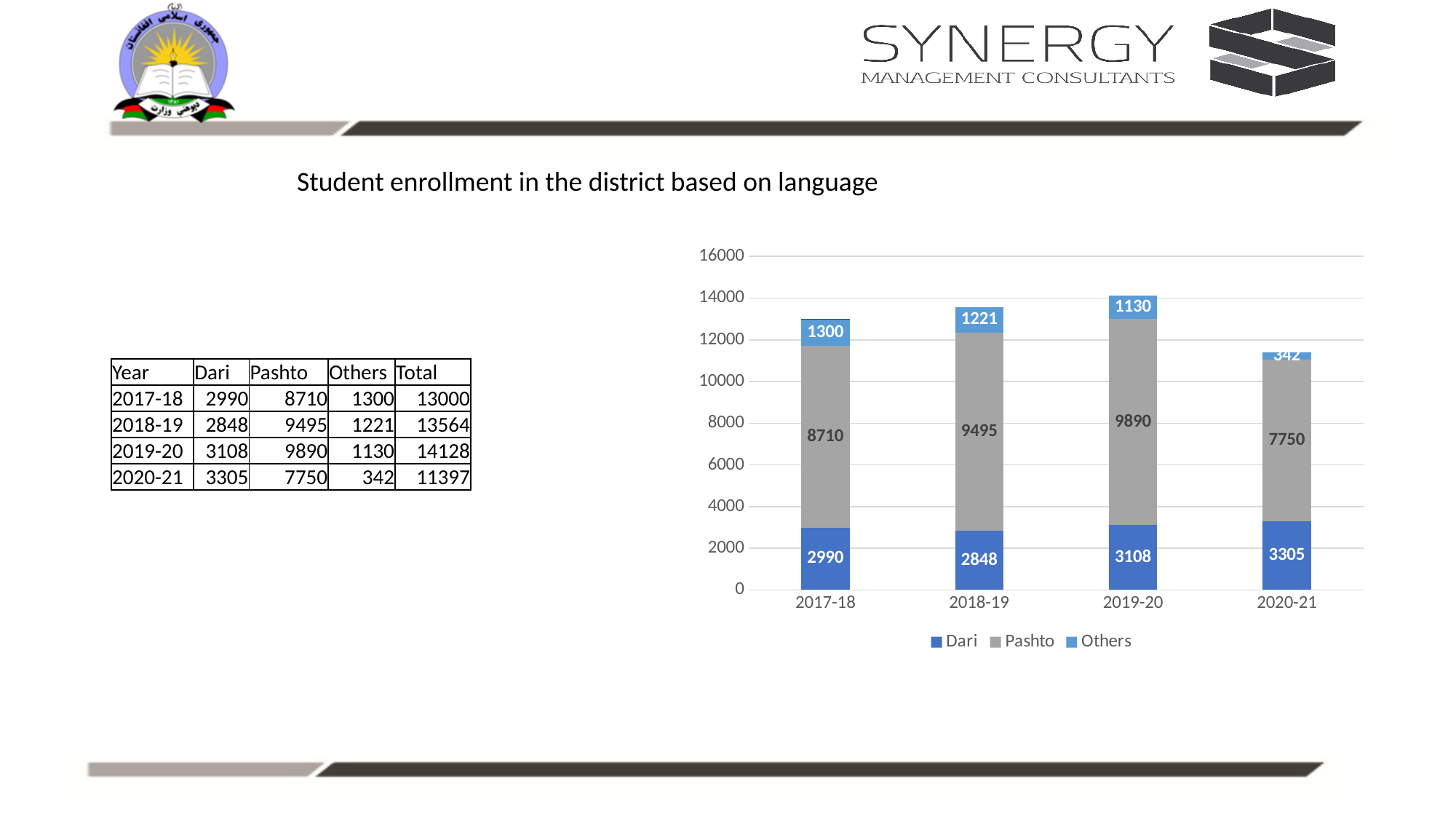
What is the Pashto enrollment value for 2018-19? 9495 Which is larger, the Dari value for 2017-18 or the Dari value for 2018-19? 2017-18 How many years are shown on the x axis of the chart? 4 What is the difference between the Pashto values for 2019-20 and 2020-21? 2140 Which year has the lowest Others enrollment? 2020-21 What is the Dari enrollment value for 2019-20? 3108 How many series does the chart legend list? 3 Which year has the highest Pashto enrollment? 2019-20 Is the total stacked bar for 2020-21 greater or less than 12000? less What is the Others enrollment value for 2020-21? 342 What is the total of the stacked bar for 2018-19? 13564 What kind of chart is shown on the slide? stacked bar chart